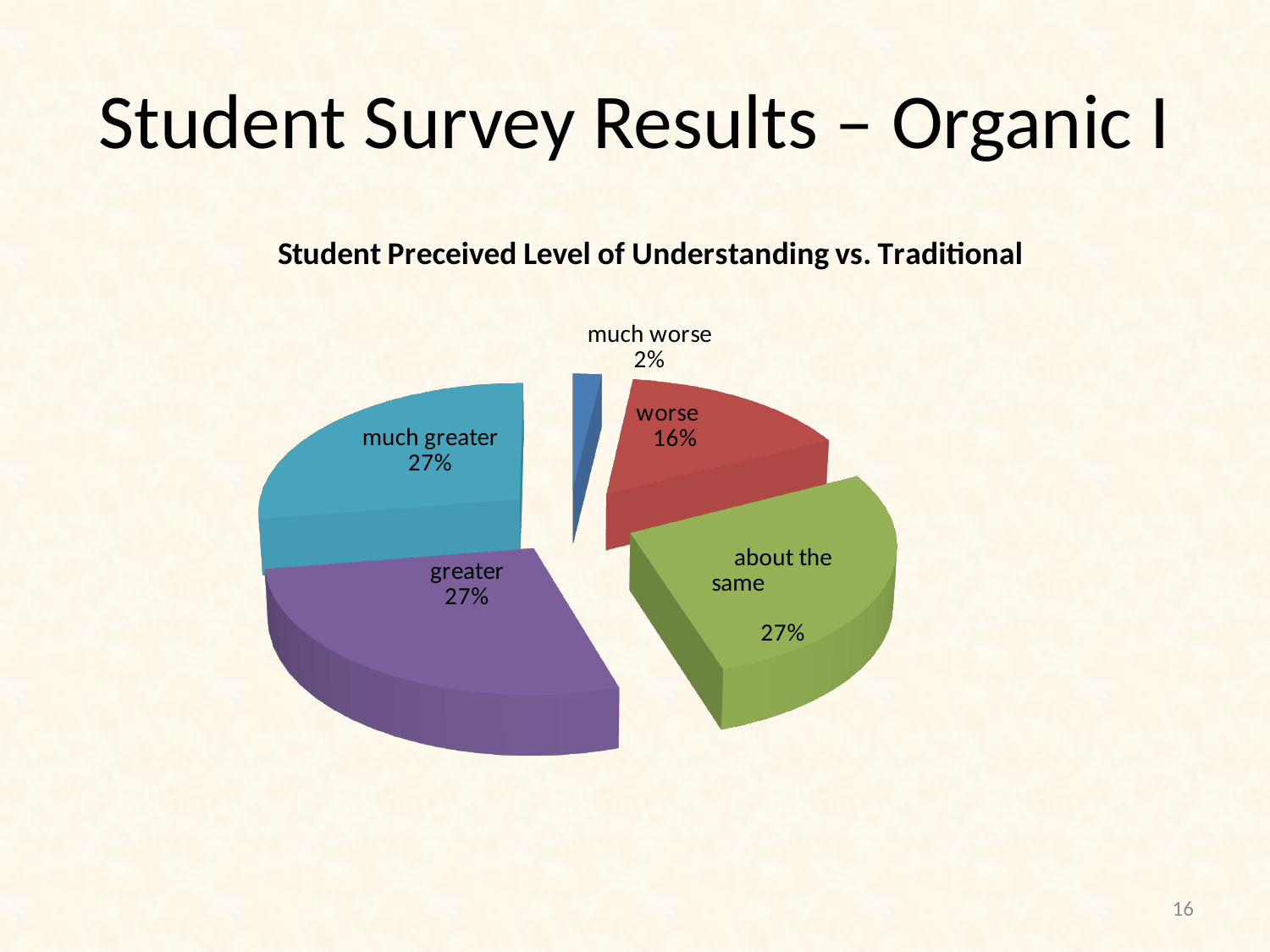
Which category has the smallest slice of the pie? much worse How many slices does the pie chart have? 5 What percentage of students reported a 'worse' level of understanding? 16% What percentage of students reported a 'much worse' level of understanding? 2% What is the title of the chart? Student Preceived Level of Understanding vs. Traditional What share of the pie is 'about the same'? 27% What share of the pie is 'much greater'? 27% What colour is the 'greater' slice? purple What kind of chart is shown on the slide? pie chart What is the difference in percentage points between the 'worse' slice and the 'much worse' slice? 14% What percentage of students reported a 'greater' level of understanding? 27% Which is larger, the 'worse' slice or the 'much worse' slice? worse